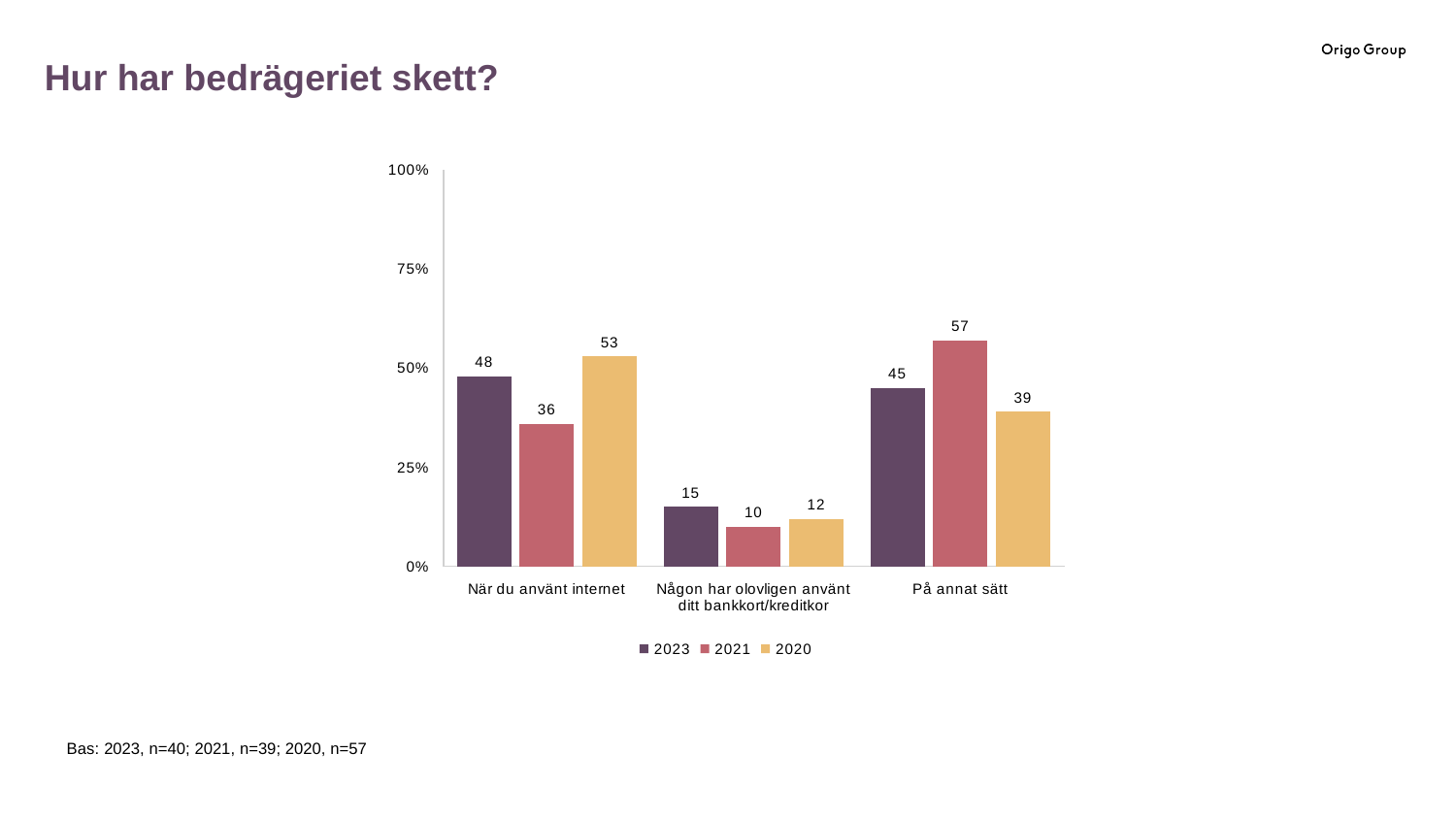
What is the value for 2021 in the category 'På annat sätt'? 57 How many series does the legend list? 3 How many categories are shown on the x axis? 3 What is the value for 2020 in the category 'Någon har olovligen använt ditt bankkort/kreditkor'? 12 What is the title of the chart? Hur har bedrägeriet skett? Which is larger for 'När du använt internet': the 2023 value or the 2021 value? 2023 Which category has the highest value for the 2020 series? När du använt internet What is the value for 2023 in the category 'När du använt internet'? 48 Is the 2021 value for 'På annat sätt' greater or less than 50%? greater What kind of chart is shown on the slide? bar chart What is the difference between the 2021 and 2023 values for 'På annat sätt'? 12 Which category has the lowest value for the 2021 series? Någon har olovligen använt ditt bankkort/kreditkor